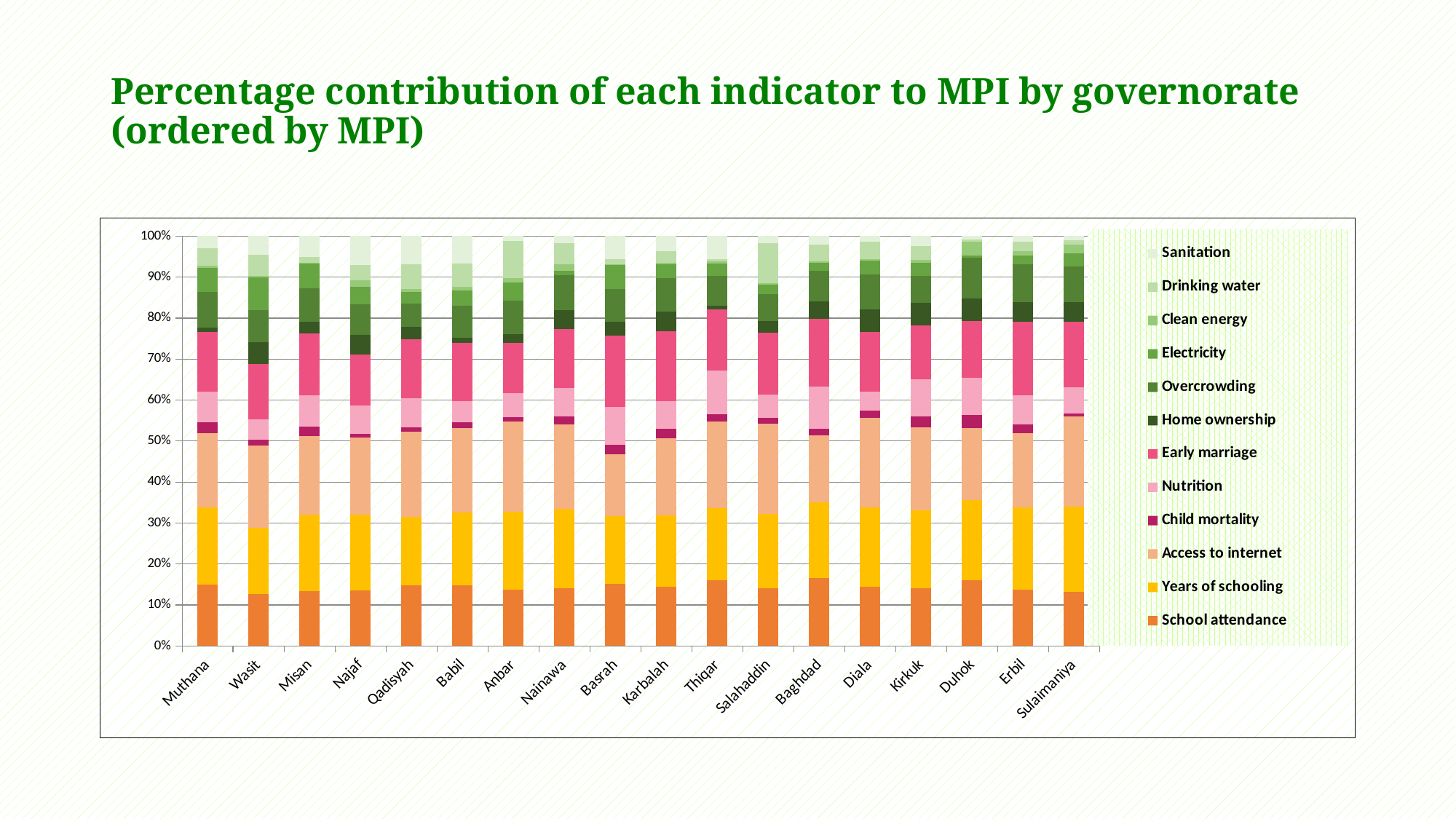
Is the School attendance value for Thiqar greater or less than 10%? greater What kind of chart is shown on the slide? Stacked bar chart What is the title of the chart on the slide? Percentage contribution of each indicator to MPI by governorate (ordered by MPI) Is the School attendance value for Muthana greater or less than 10%? greater Is the School attendance value for Baghdad greater or less than 20%? less How many indicators (series) does the chart legend list? 12 Which has the larger School attendance segment, Wasit or Baghdad? Baghdad What is the total of the stacked bar for Muthana? 100% Which indicator is listed last in the chart legend? School attendance Which governorate appears first on the x axis of the chart? Muthana How many governorates are shown along the x axis of the chart? 18